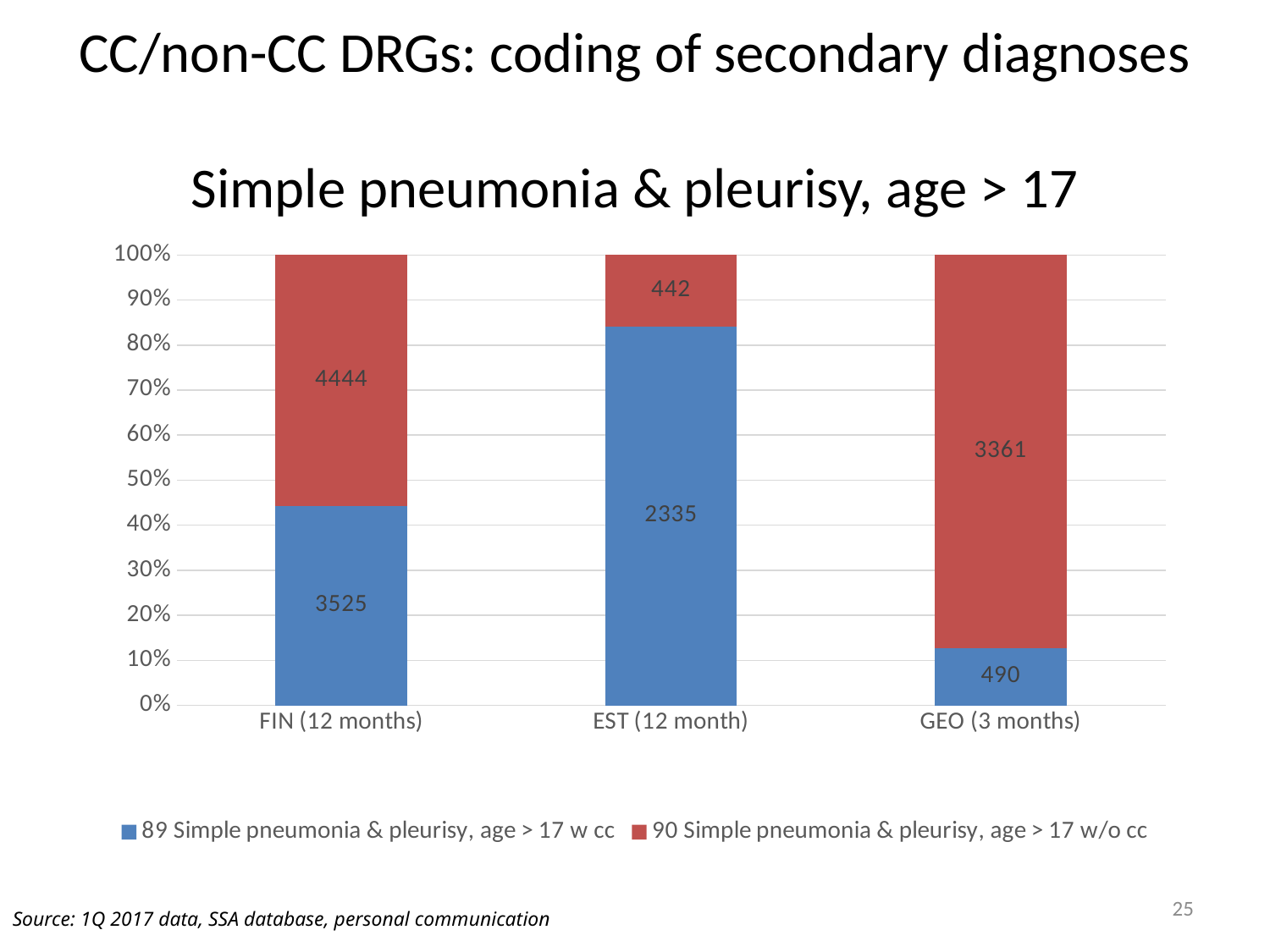
Which category has the highest value for '90 Simple pneumonia & pleurisy, age > 17 w/o cc'? FIN (12 months) What is the value for '89 Simple pneumonia & pleurisy, age > 17 w cc' for FIN (12 months)? 3525 What is the total of the two series for GEO (3 months)? 3851 What kind of chart is shown on the slide? Stacked bar chart (100%) What is the value for '90 Simple pneumonia & pleurisy, age > 17 w/o cc' for GEO (3 months)? 3361 What is the value for '89 Simple pneumonia & pleurisy, age > 17 w cc' for GEO (3 months)? 490 What is the value for '90 Simple pneumonia & pleurisy, age > 17 w/o cc' for EST (12 month)? 442 How many categories are shown on the x axis? 3 Which category has the lowest value for '89 Simple pneumonia & pleurisy, age > 17 w cc'? GEO (3 months) How many series does the legend list? 2 For EST (12 month), which is larger: the 'w cc' value or the 'w/o cc' value? w cc (2335) What is the difference between the 'w/o cc' and 'w cc' values for FIN (12 months)? 919